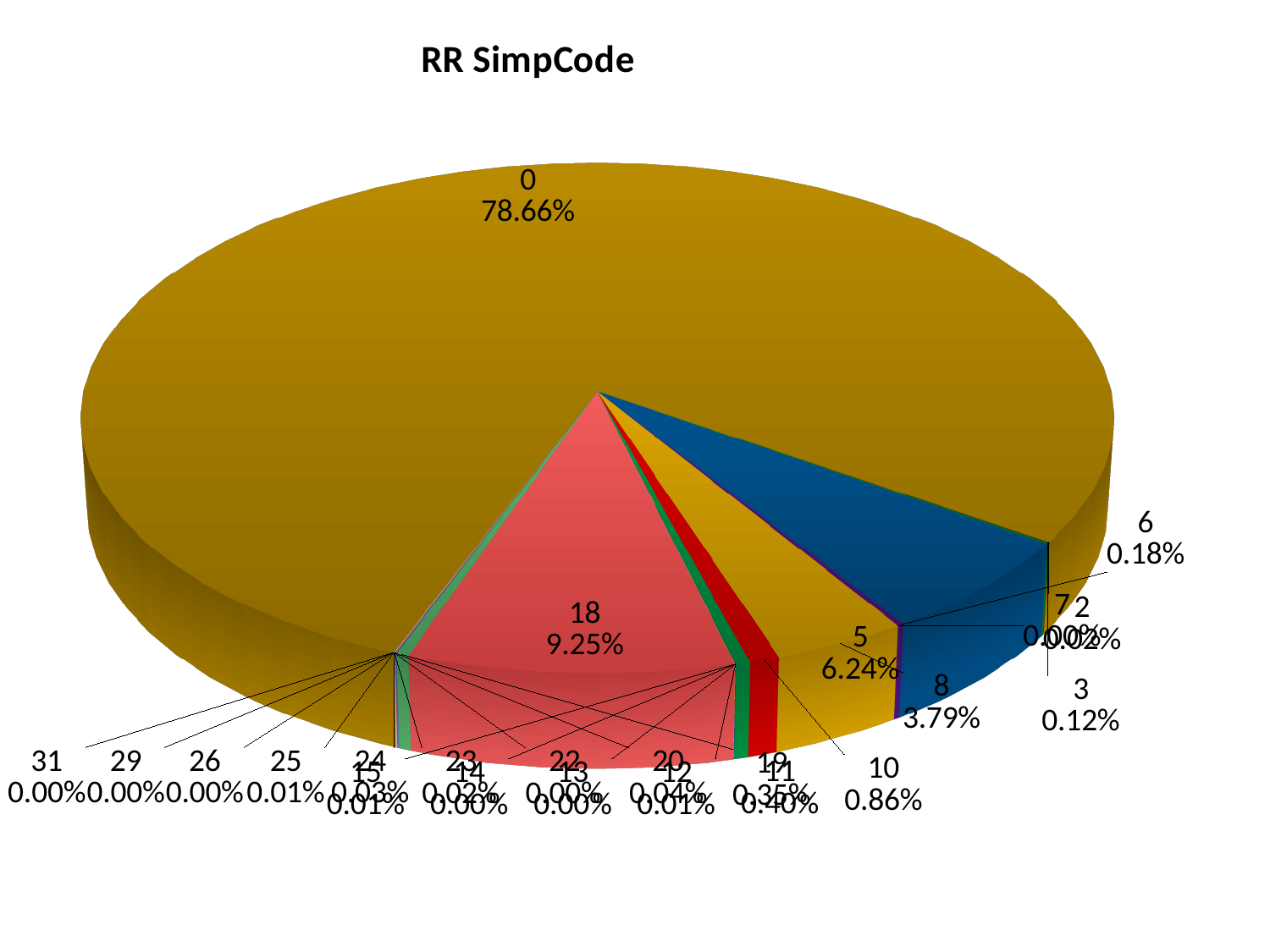
What is the title of the chart? RR SimpCode What is the percentage shown for category 6? 0.18% What share of the pie does category 0 have? 78.66% Which category has the largest slice of the pie? 0 What is the difference between the shares of category 18 and category 5? 3.01% What is the percentage shown for category 5? 6.24% What is the percentage shown for category 10? 0.86% What kind of chart is shown on the slide? pie chart What is the percentage shown for category 3? 0.12% Which is larger, the share for category 8 or the share for category 10? 8 What is the percentage shown for category 8? 3.79% What is the percentage shown for category 18? 9.25%